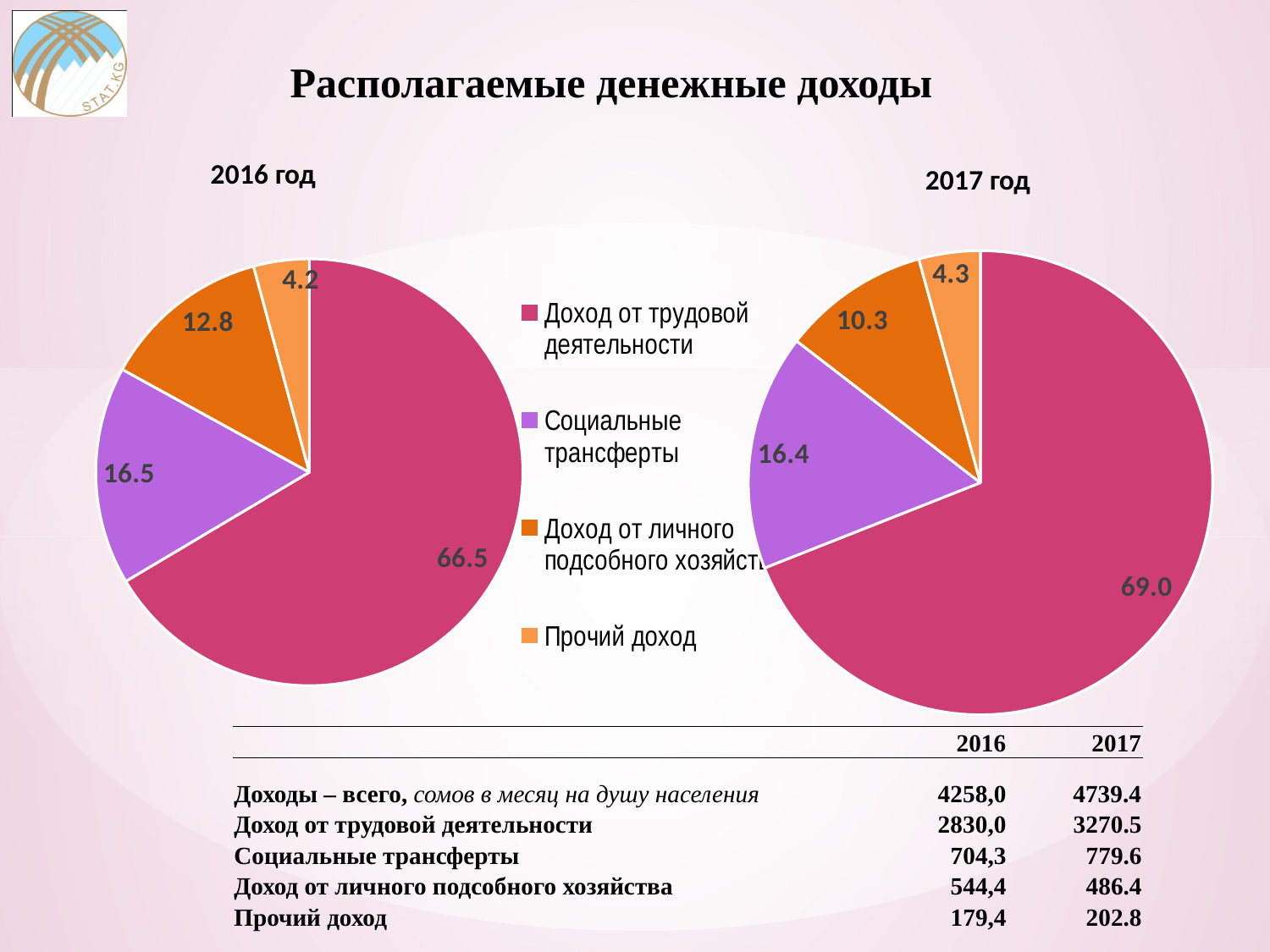
Which is larger: Доход от личного подсобного хозяйства in the 2016 год chart or in the 2017 год chart? 2016 год In the 2017 год pie chart, what is the value shown for Доход от личного подсобного хозяйства? 10.3 What type of chart is used to show the 2016 год data? Pie chart Which colour represents Социальные трансферты in the pie charts? Purple In the 2017 год pie chart, which category has the smallest slice? Прочий доход What is the difference between the Доход от трудовой деятельности value in the 2017 год chart and in the 2016 год chart? 2.5 In the 2016 год pie chart, what is the difference between Социальные трансферты and Доход от личного подсобного хозяйства? 3.7 In the 2016 год pie chart, which category has the largest slice? Доход от трудовой деятельности In the 2017 год pie chart, what is the value shown for Социальные трансферты? 16.4 In the 2016 год pie chart, what is the value shown for Доход от трудовой деятельности? 66.5 In the 2016 год pie chart, what is the value shown for Прочий доход? 4.2 How many slices does the 2017 год pie chart have? 4